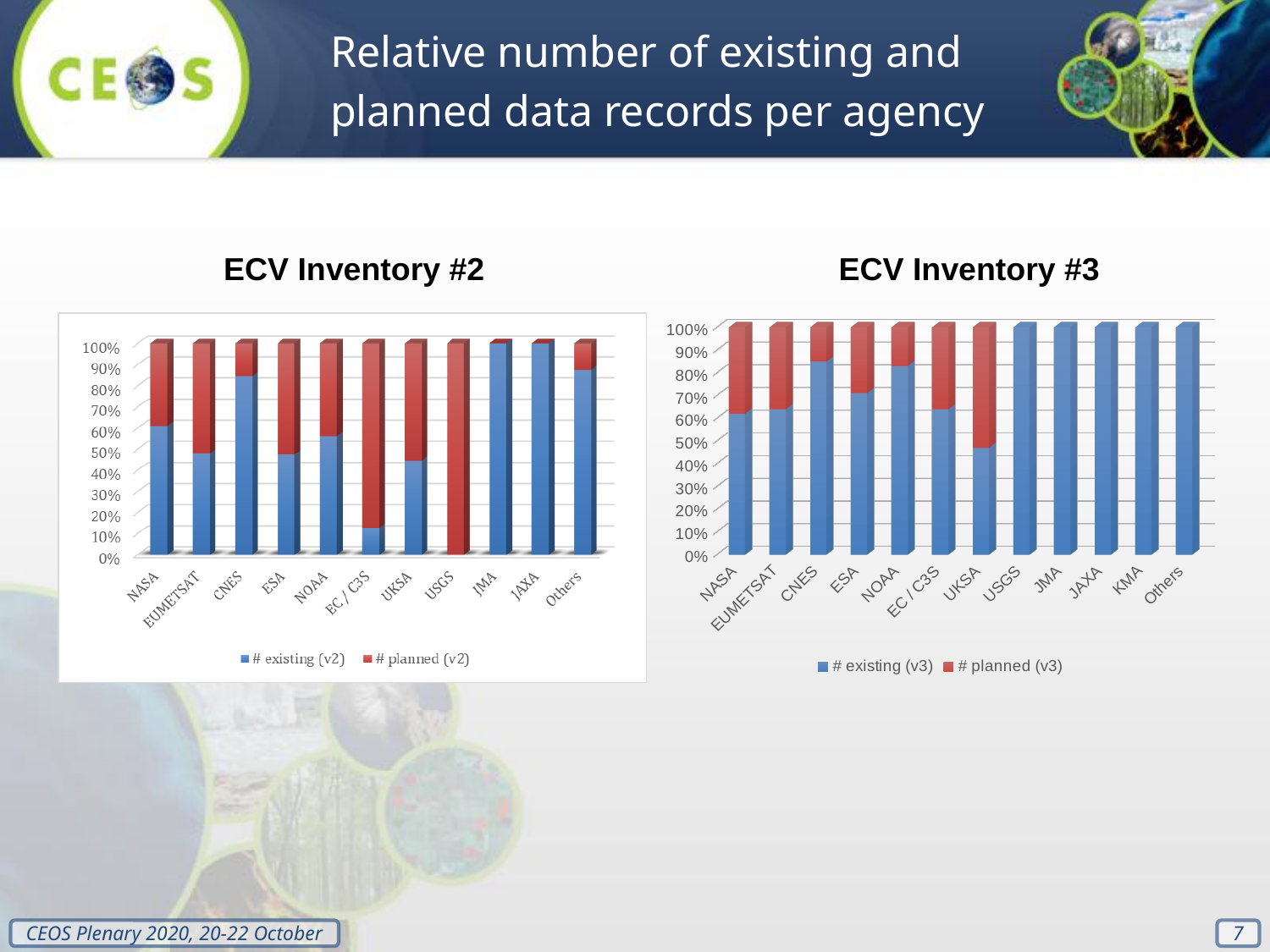
How many series does the legend of the ECV Inventory #3 chart list? 2 In the ECV Inventory #3 chart, which agency has the lowest share of existing data records? UKSA What are the two legend entries of the ECV Inventory #2 chart? # existing (v2) and # planned (v2) In the ECV Inventory #2 chart, which agency has the lowest share of existing data records? USGS How many agencies (categories) are shown on the x axis of the ECV Inventory #2 chart? 11 In the ECV Inventory #3 chart, is the share of existing records for CNES greater or less than 70%? greater In the ECV Inventory #3 chart, which agency has the highest share of planned data records? UKSA What kind of chart is the ECV Inventory #2 chart? Stacked bar chart How many agencies (categories) are shown on the x axis of the ECV Inventory #3 chart? 12 In the ECV Inventory #3 chart, is the share of existing records for USGS greater or less than 90%? greater In the ECV Inventory #2 chart, is the share of existing records for EC / C3S greater or less than 50%? less In the ECV Inventory #2 chart, which has the larger share of existing records, CNES or ESA? CNES